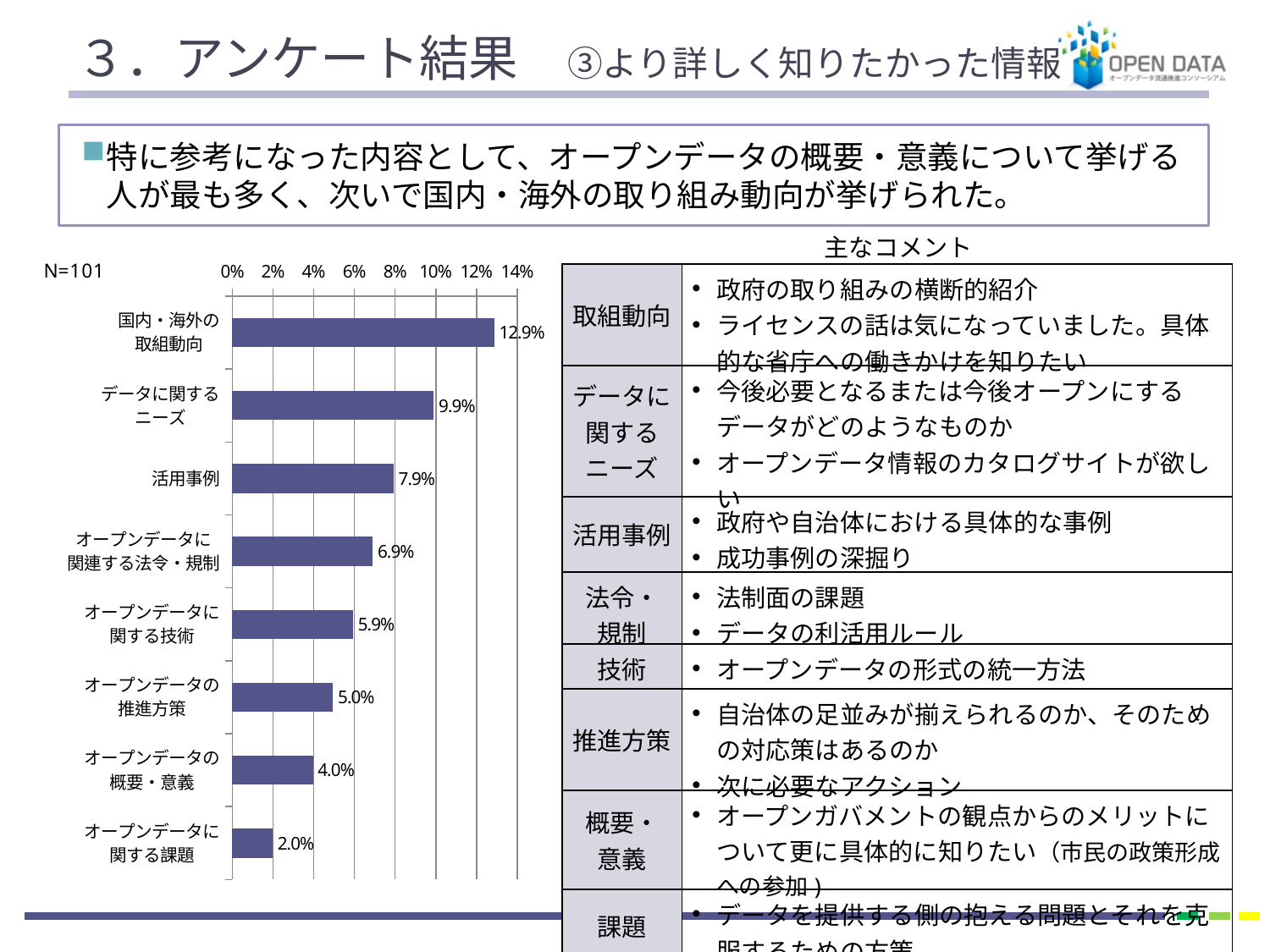
Which category has the highest value? 国内・海外の取組動向 What is the sample size (N) shown next to the chart? N=101 Is the value for オープンデータに関連する法令・規制 greater or less than 8%? less Which category has the lowest value? オープンデータに関する課題 What is the value for オープンデータに関する技術? 5.9% How many categories are shown in the bar chart? 8 Which is larger, the value for 活用事例 or the value for オープンデータの推進方策? 活用事例 What is the difference between the values for 国内・海外の取組動向 and データに関するニーズ? 3.0% What is the value for 国内・海外の取組動向? 12.9% What is the value for データに関するニーズ? 9.9% What kind of chart is shown on the slide? bar chart What is the value for オープンデータの概要・意義? 4.0%